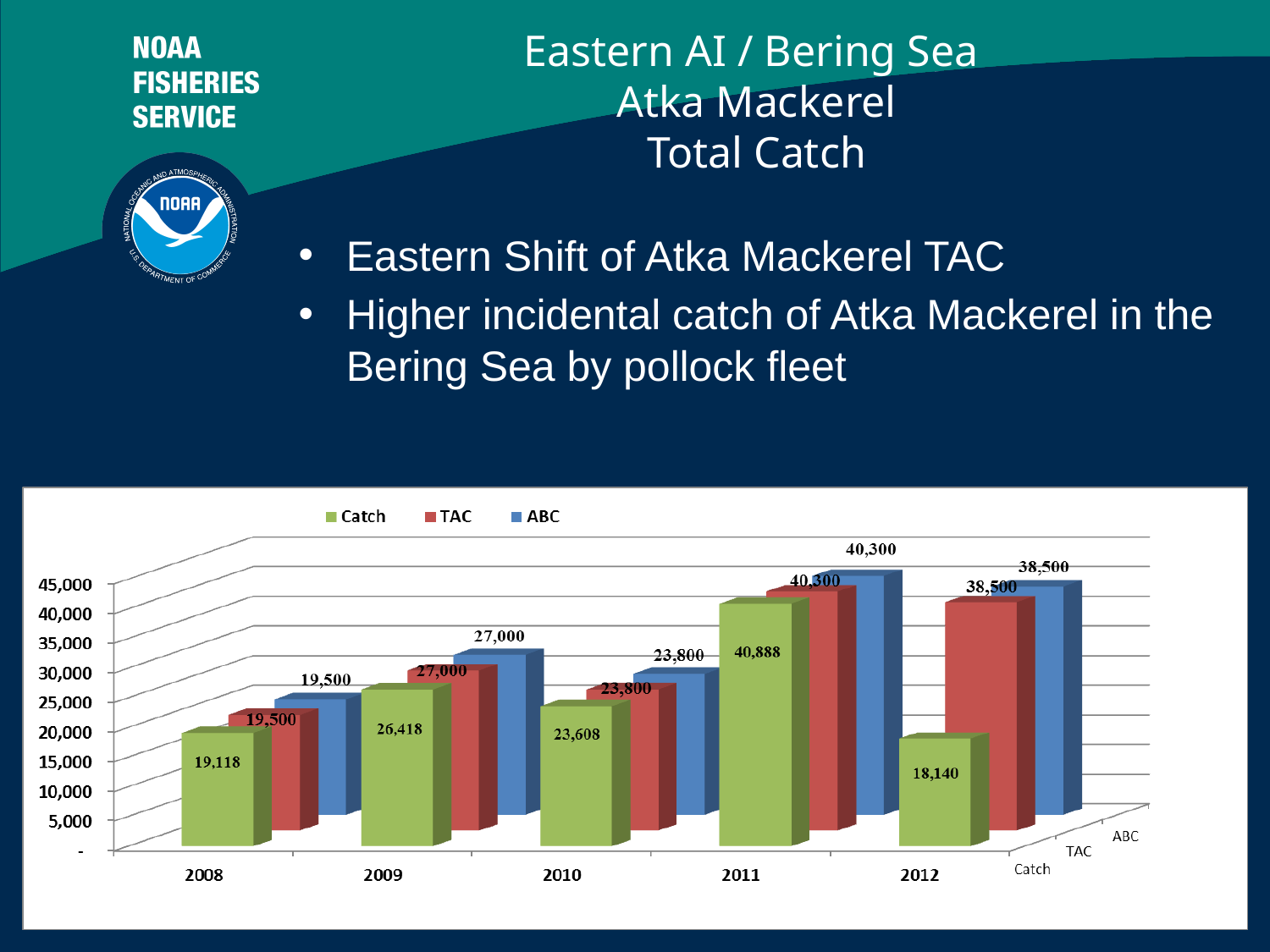
What was the Catch value in 2012? 18,140 How many years are shown on the x axis? 5 Which was larger in 2009, the Catch or the TAC? TAC Is the Catch value for 2010 greater or less than 20,000? greater What was the Catch value in 2011? 40,888 What is the difference between the TAC and the Catch in 2012? 20,360 What kind of chart is shown on the slide? Bar chart What was the TAC in 2012? 38,500 How many series does the legend list? 3 What was the ABC in 2009? 27,000 In which year was the Catch highest? 2011 In which year was the Catch lowest? 2012